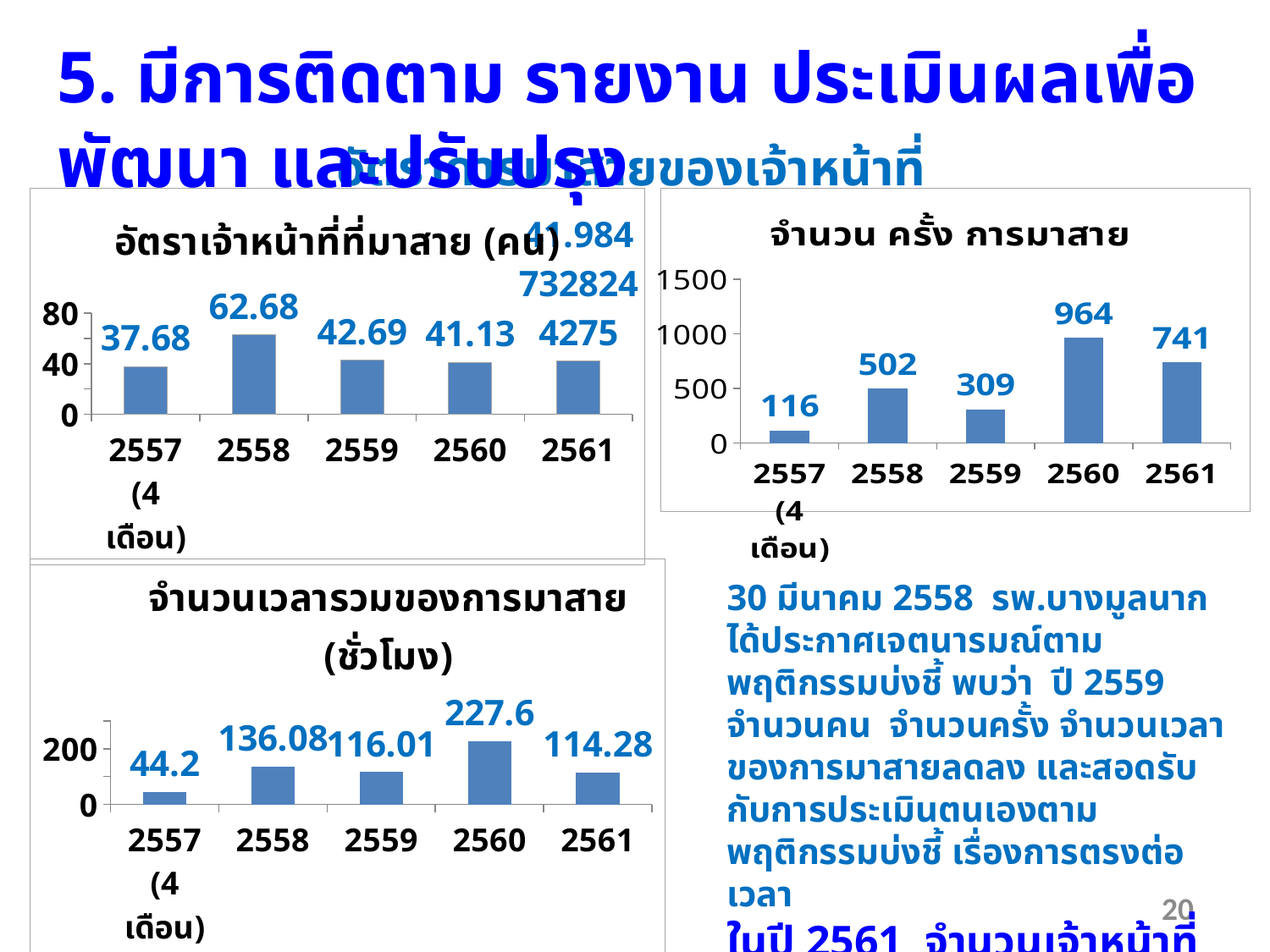
In the chart titled "จำนวน ครั้ง การมาสาย", what is the difference between the values for 2560 and 2561? 223 What type of chart is the chart titled "จำนวน ครั้ง การมาสาย"? bar chart In the chart titled "อัตราเจ้าหน้าที่ที่มาสาย (คน)", which year has the highest value? 2558 In the chart titled "จำนวนเวลารวมของการมาสาย (ชั่วโมง)", which year has the lowest value? 2557 (4 เดือน) In the chart titled "จำนวน ครั้ง การมาสาย", what is the value for 2560? 964 In the chart titled "อัตราเจ้าหน้าที่ที่มาสาย (คน)", which is larger, the value for 2557 (4 เดือน) or the value for 2559? 2559 How many categories are shown in the chart titled "จำนวนเวลารวมของการมาสาย (ชั่วโมง)"? 5 In the chart titled "จำนวน ครั้ง การมาสาย", is the value for 2558 greater or less than 1000? less In the chart titled "จำนวน ครั้ง การมาสาย", which year has the lowest value? 2557 (4 เดือน) In the chart titled "จำนวนเวลารวมของการมาสาย (ชั่วโมง)", what is the value for 2560? 227.6 In the chart titled "อัตราเจ้าหน้าที่ที่มาสาย (คน)", what is the value for 2558? 62.68 In the chart titled "จำนวนเวลารวมของการมาสาย (ชั่วโมง)", what is the difference between the values for 2558 and 2559? 20.07